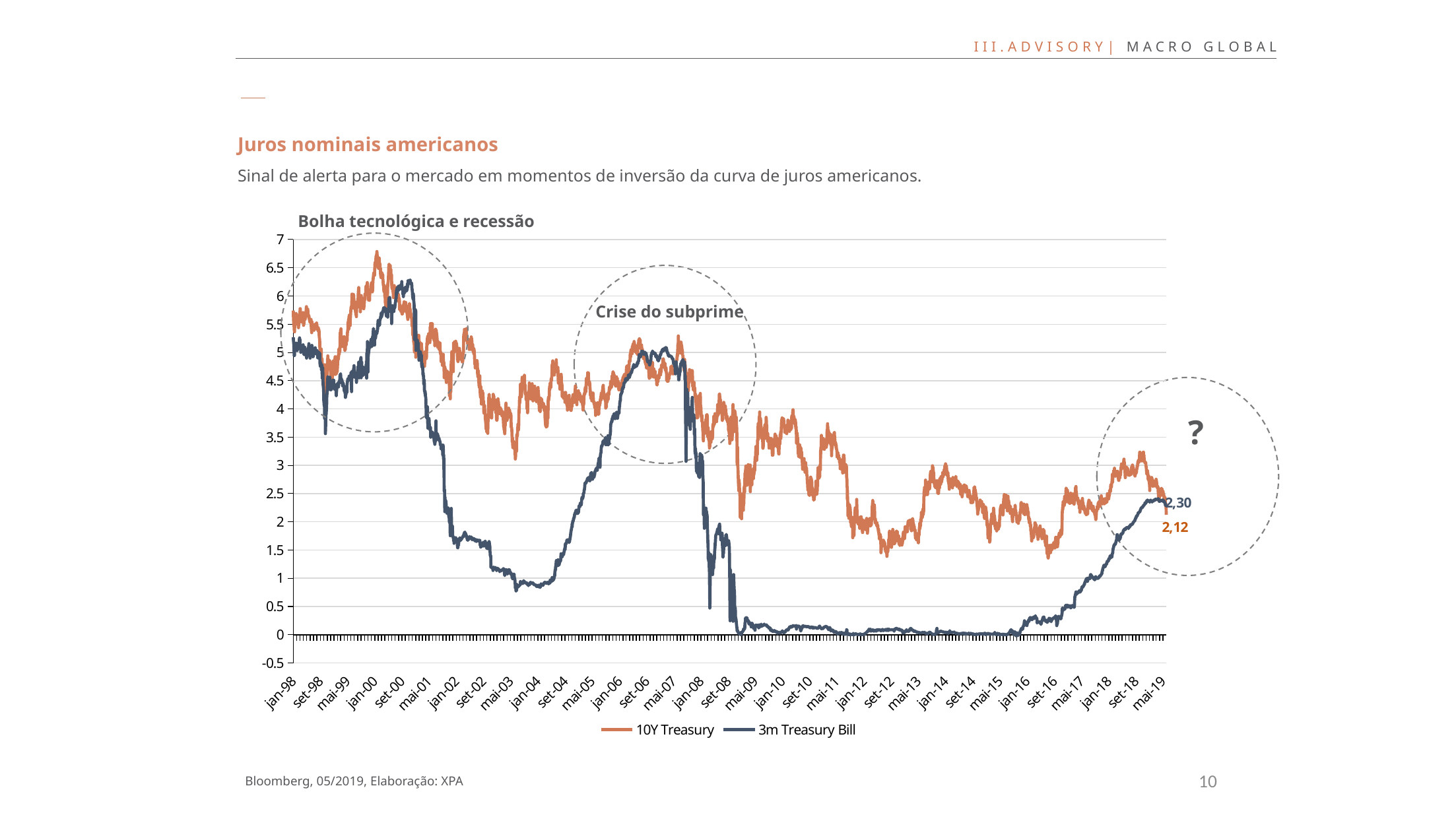
What is the difference between the final labelled values of the 3m Treasury Bill (2,30) and the 10Y Treasury (2,12)? 0,18 How many series does the legend list? 2 What kind of chart is shown on the slide? line chart What is the last labelled value of the 3m Treasury Bill series? 2,30 At the end of the series (mai-19), which is higher: the 10Y Treasury or the 3m Treasury Bill? 3m Treasury Bill Is the value of the 3m Treasury Bill around mai-14 greater or less than 0.5? less What is the last labelled value of the 10Y Treasury series? 2,12 Which series reaches the highest value anywhere on the chart? 10Y Treasury Does the 3m Treasury Bill series rise or fall between jan-16 and mai-19? rise Is the value of the 10Y Treasury around set-12 greater or less than 2? less Is the peak of the 10Y Treasury series around jan-00 greater or less than 6? greater What is the title of the chart? Juros nominais americanos